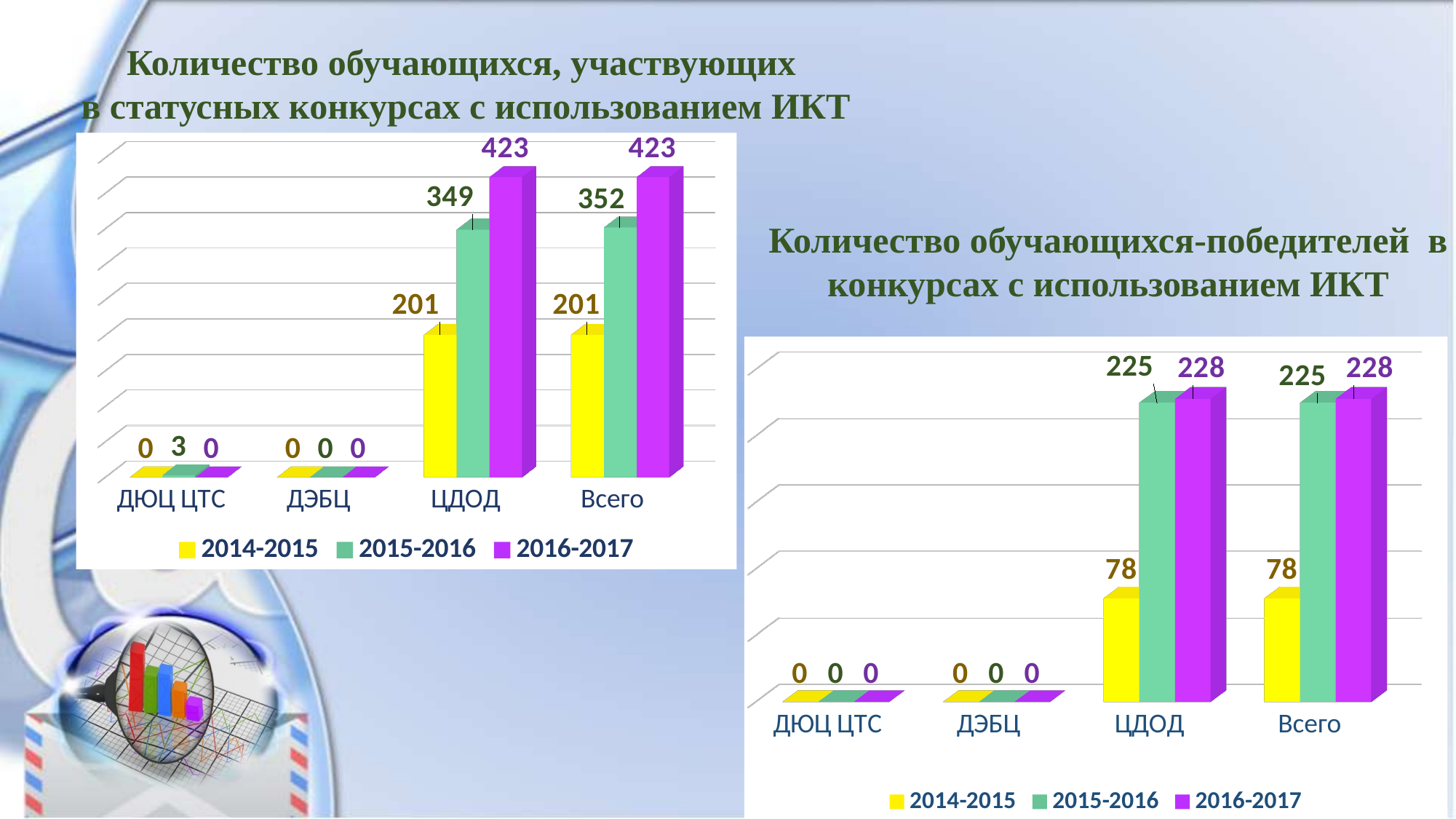
In the right chart (Количество обучающихся-победителей в конкурсах с использованием ИКТ), what is the value for Всего in 2016-2017? 228 In the left chart (Количество обучающихся, участвующих в статусных конкурсах с использованием ИКТ), what is the value for Всего in 2015-2016? 352 In the right chart (Количество обучающихся-победителей в конкурсах с использованием ИКТ), which category has the lowest value in 2015-2016, ДЭБЦ or ЦДОД? ДЭБЦ In the left chart (Количество обучающихся, участвующих в статусных конкурсах с использованием ИКТ), do the values for ЦДОД rise or fall from 2014-2015 to 2016-2017? rise In the right chart (Количество обучающихся-победителей в конкурсах с использованием ИКТ), what is the value for ЦДОД in 2014-2015? 78 In the right chart (Количество обучающихся-победителей в конкурсах с использованием ИКТ), what is the difference between the Всего values for 2015-2016 and 2014-2015? 147 What type of chart is the right chart (Количество обучающихся-победителей в конкурсах с использованием ИКТ)? bar chart In the right chart (Количество обучающихся-победителей в конкурсах с использованием ИКТ), how many categories are shown on the x axis? 4 In the left chart (Количество обучающихся, участвующих в статусных конкурсах с использованием ИКТ), what is the value for ЦДОД in 2016-2017? 423 In the left chart (Количество обучающихся, участвующих в статусных конкурсах с использованием ИКТ), how many series does the legend list? 3 In the left chart (Количество обучающихся, участвующих в статусных конкурсах с использованием ИКТ), what is the value for ДЮЦ ЦТС in 2015-2016? 3 In the left chart (Количество обучающихся, участвующих в статусных конкурсах с использованием ИКТ), what is the difference between the ЦДОД values for 2016-2017 and 2014-2015? 222